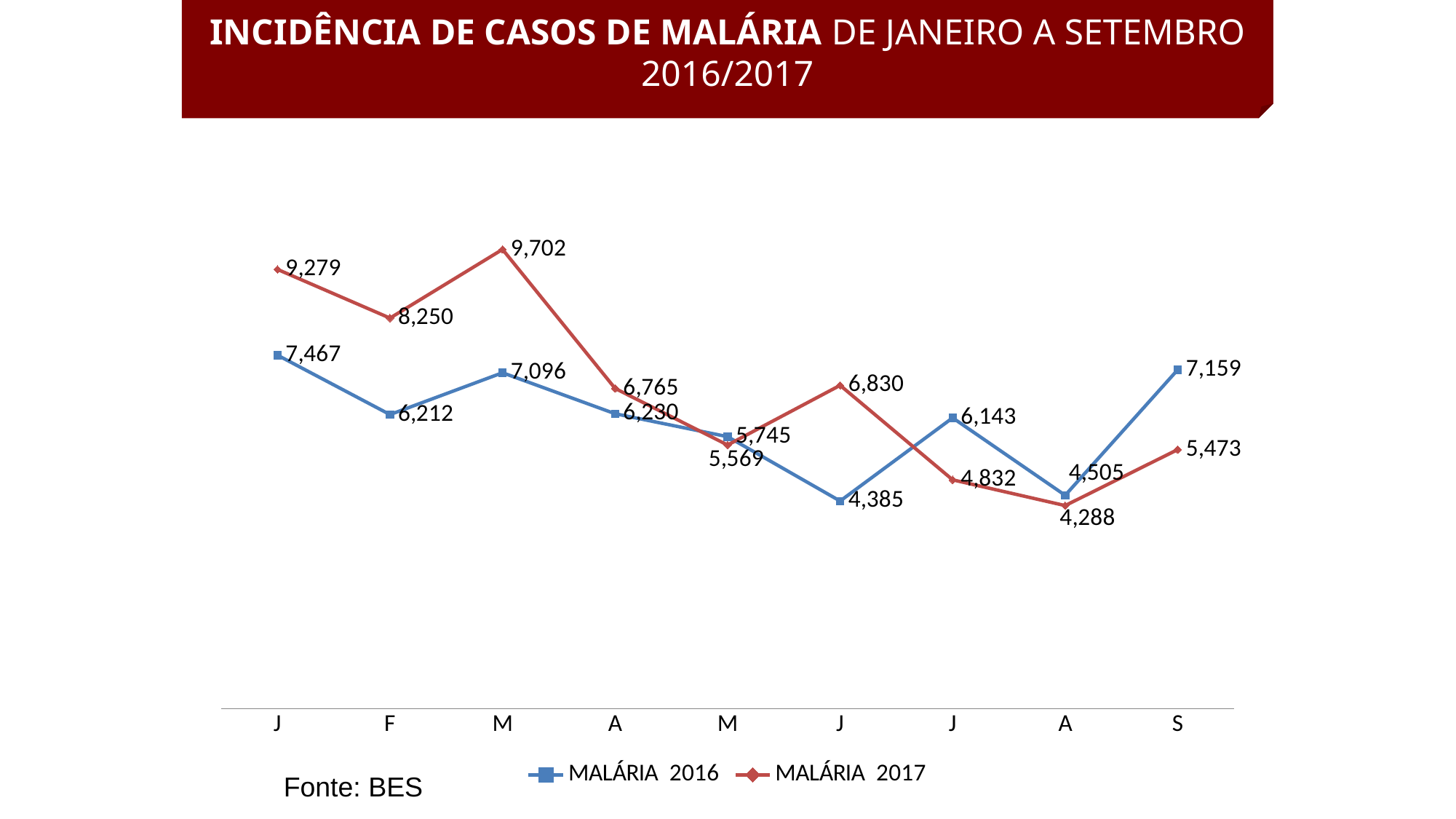
What is the lowest value plotted for the MALÁRIA 2016 series? 4,385 What is the difference between MALÁRIA 2016 and MALÁRIA 2017 at the last point (September, S)? 1,686 What is the difference between MALÁRIA 2017 and MALÁRIA 2016 at the first point (January, J)? 1,812 How many series does the legend list? 2 What is the value for MALÁRIA 2016 at the seventh point (July, J)? 6,143 Does the MALÁRIA 2017 series rise or fall from the third point (March, M) to the fifth point (May, M)? Fall How many points (months) are plotted along the x axis? 9 What is the value for MALÁRIA 2017 at the first point (January, J)? 9,279 What kind of chart is shown on the slide? Line chart What is the value for MALÁRIA 2016 at the last point (September, S)? 7,159 What is the highest value plotted for the MALÁRIA 2017 series? 9,702 At the eighth point (August, A), which series has the larger value, MALÁRIA 2016 or MALÁRIA 2017? MALÁRIA 2016